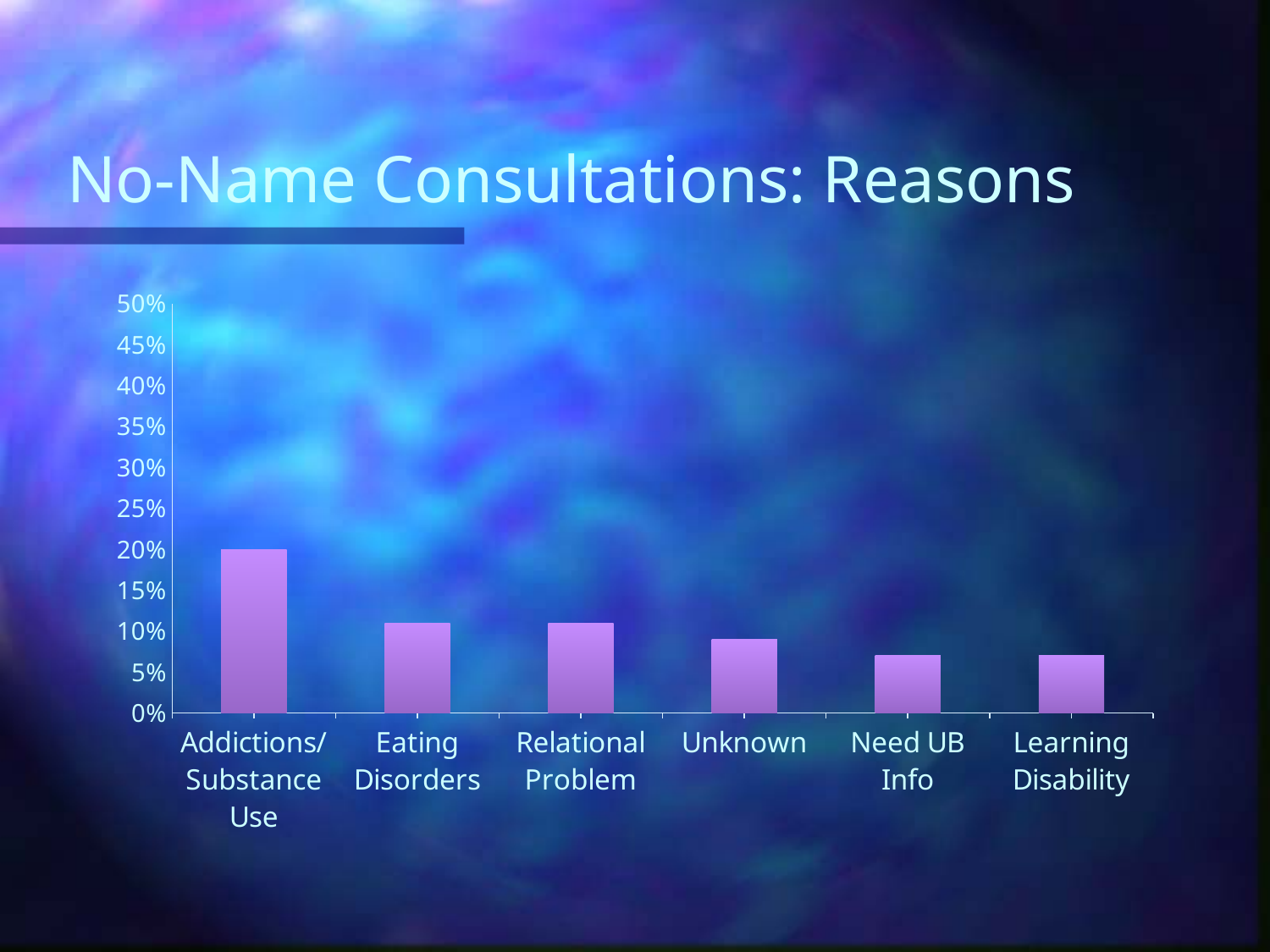
What is the highest value shown on the y axis? 50% Is the value for Eating Disorders greater or less than 15%? less Which reason has the highest percentage? Addictions/Substance Use Which is larger, the value for Addictions/Substance Use or the value for Relational Problem? Addictions/Substance Use Is the value for Learning Disability greater or less than 10%? less What is the title of the chart? No-Name Consultations: Reasons Which is larger, the value for Relational Problem or the value for Need UB Info? Relational Problem What kind of chart is shown on the slide? bar chart Do the values generally rise or fall moving from left to right along the x axis? fall How many reason categories are shown on the x axis? 6 Is the value for Addictions/Substance Use greater or less than 15%? greater